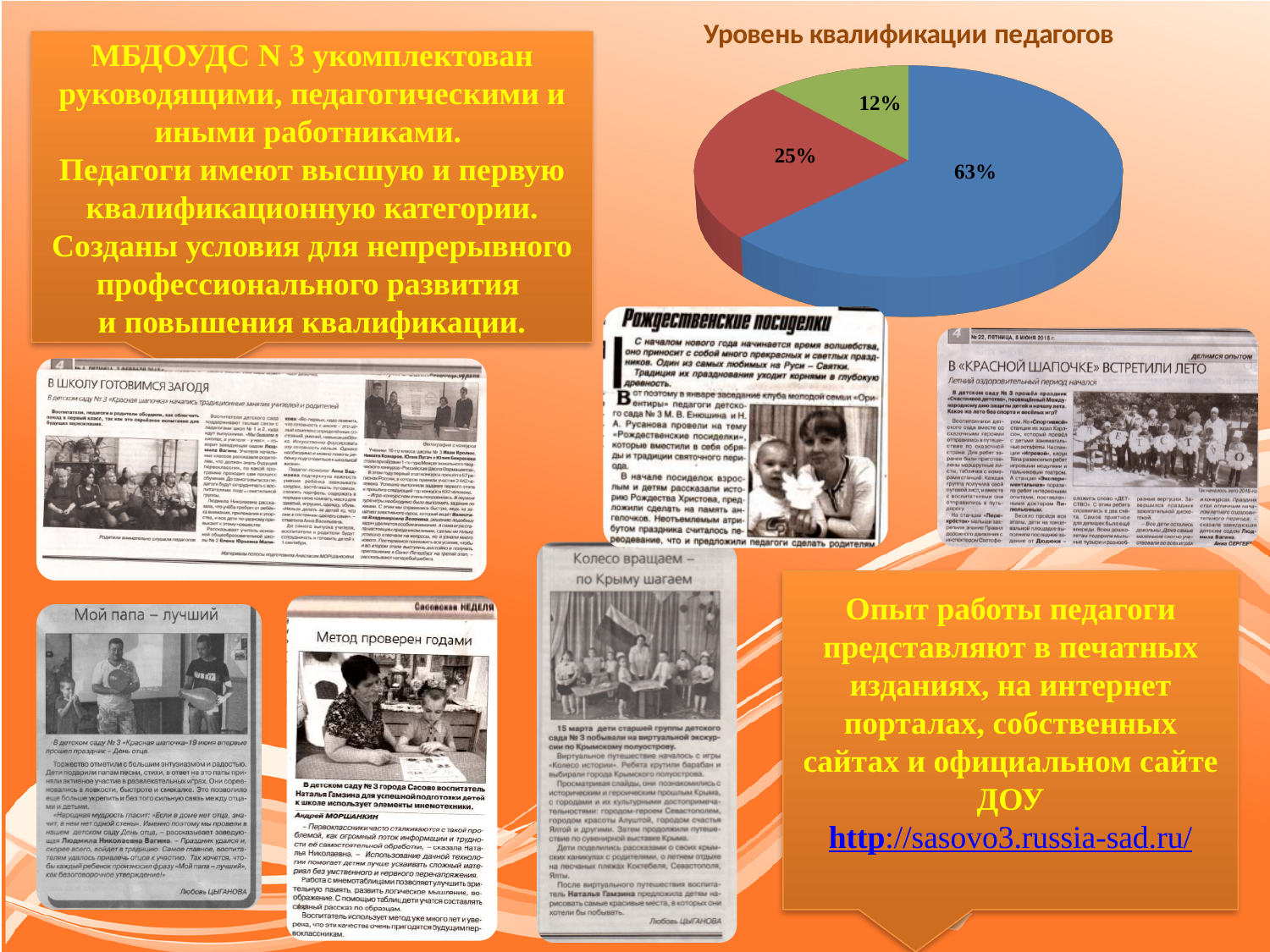
Which slice is larger in the pie chart, the red one or the green one? the red one What is the largest value shown in the pie chart? 63% How many slices does the pie chart have? 3 What is the title of the chart on the slide? Уровень квалификации педагогов What kind of chart is shown under the title "Уровень квалификации педагогов"? pie chart What is the difference between the largest and the smallest slice of the pie chart? 51% What percentage is shown on the green slice of the pie chart? 12% What is the smallest value shown in the pie chart? 12% What is the difference between the 25% slice and the 12% slice in the pie chart? 13% What colour is the largest slice of the pie chart? blue What percentage is shown on the red slice of the pie chart? 25% What percentage is shown on the blue slice of the pie chart? 63%